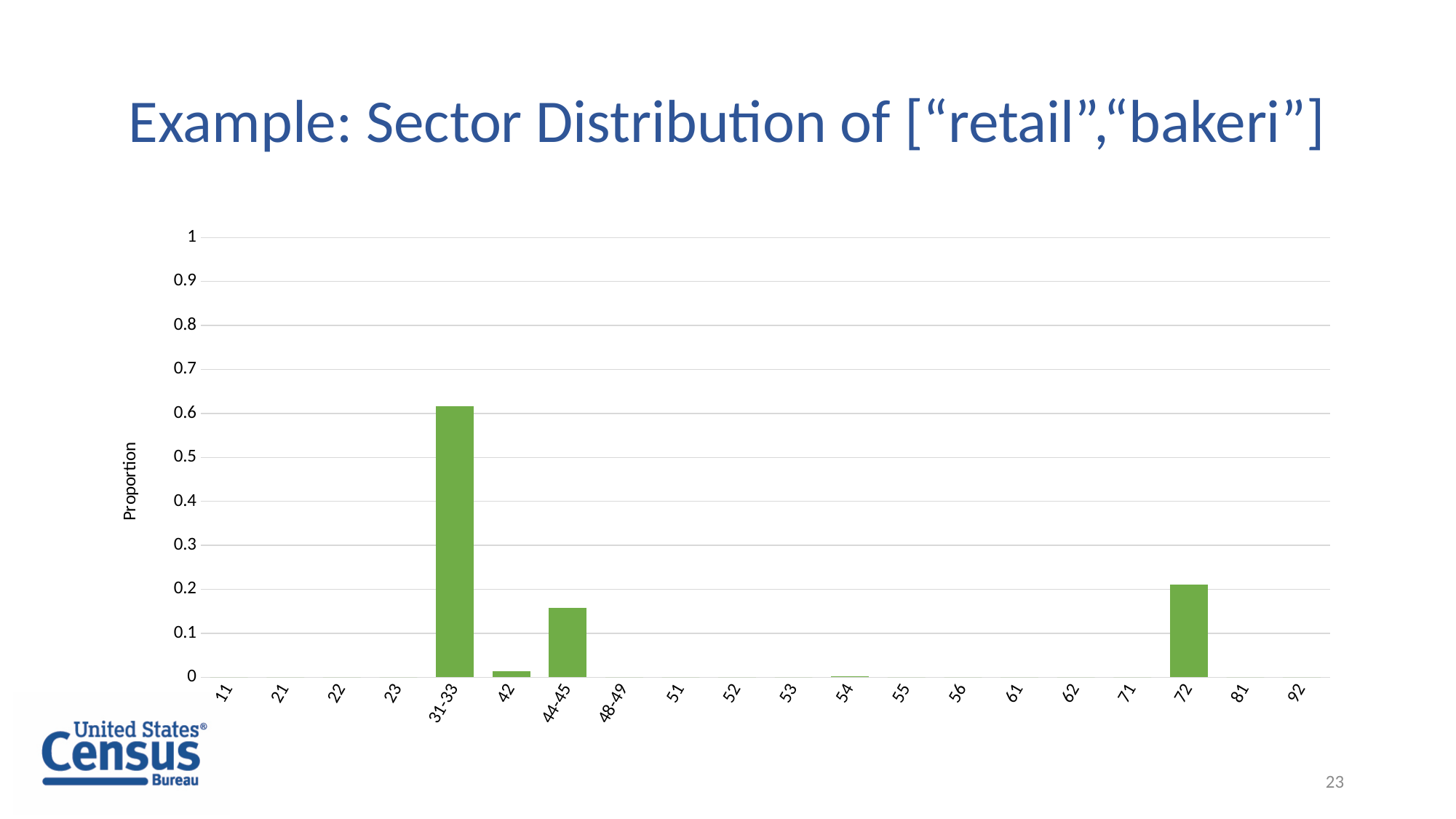
Is the proportion for sector 44-45 greater or less than 0.2? less Is the proportion for sector 42 greater or less than 0.1? less Which sector has the larger proportion, 44-45 or 72? 72 Is the proportion for sector 72 greater or less than 0.3? less What is the label of the y axis? Proportion Which sector has the larger proportion, 31-33 or 72? 31-33 What kind of chart is shown on the slide? bar chart How many sector categories are shown on the x axis? 20 Which sector has the highest proportion? 31-33 What is the title of the slide? Example: Sector Distribution of ["retail","bakeri"]